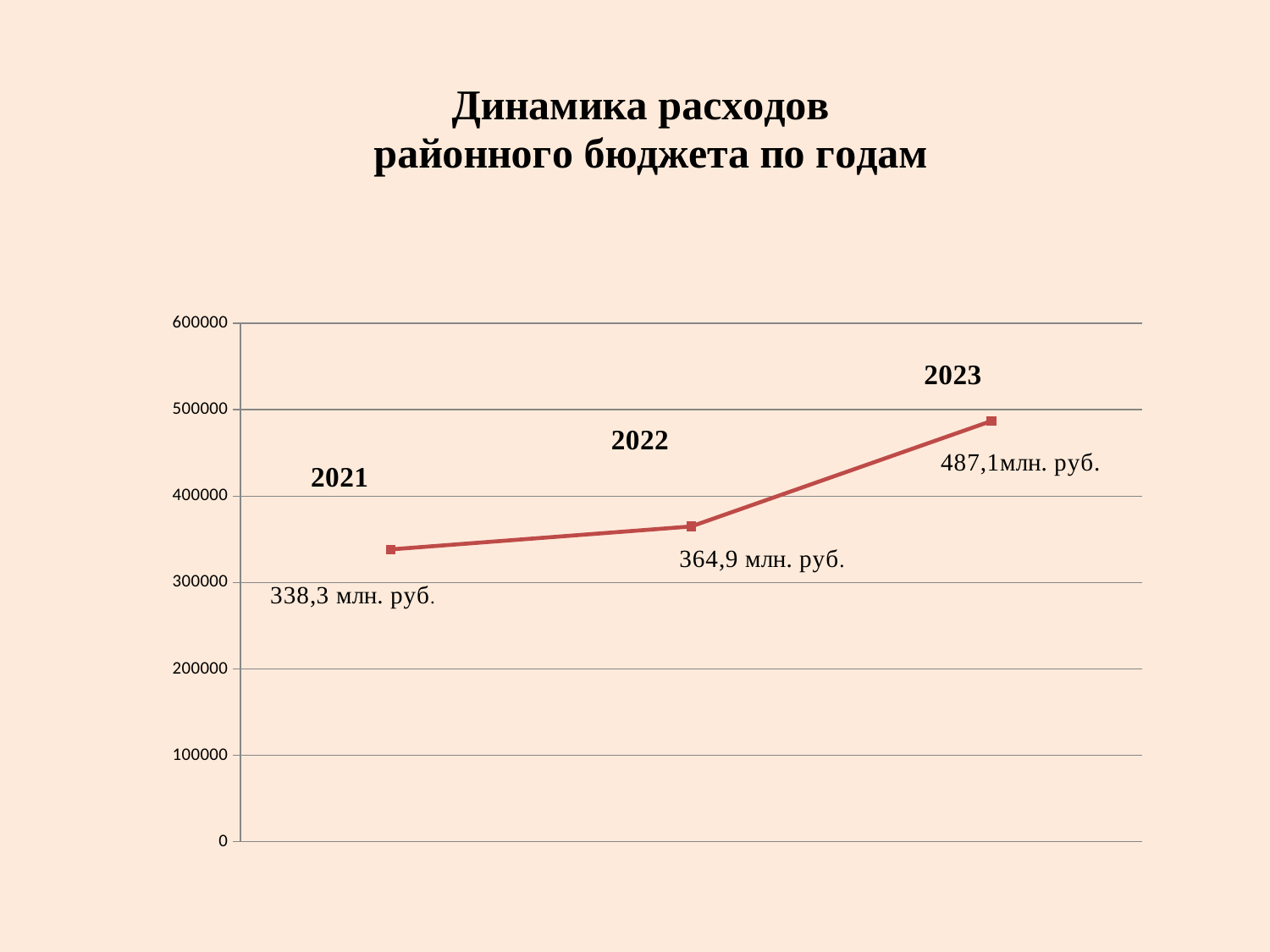
What is the value labelled for 2021? 338,3 млн. руб. Which year has the highest value? 2023 What is the title of the chart on the slide? Динамика расходов районного бюджета по годам Which is larger, the value for 2022 or the value for 2023? 2023 How many data points are plotted on the chart? 3 What is the difference between the 2023 value and the 2021 value, in млн. руб.? 148,8 млн. руб. What is the value labelled for 2023? 487,1 млн. руб. What type of chart is shown on the slide? line chart Do the values rise or fall from 2021 to 2023? rise Is the plotted point for 2023 greater or less than 500000 on the vertical axis? less What is the value labelled for 2022? 364,9 млн. руб. Which year has the lowest value? 2021